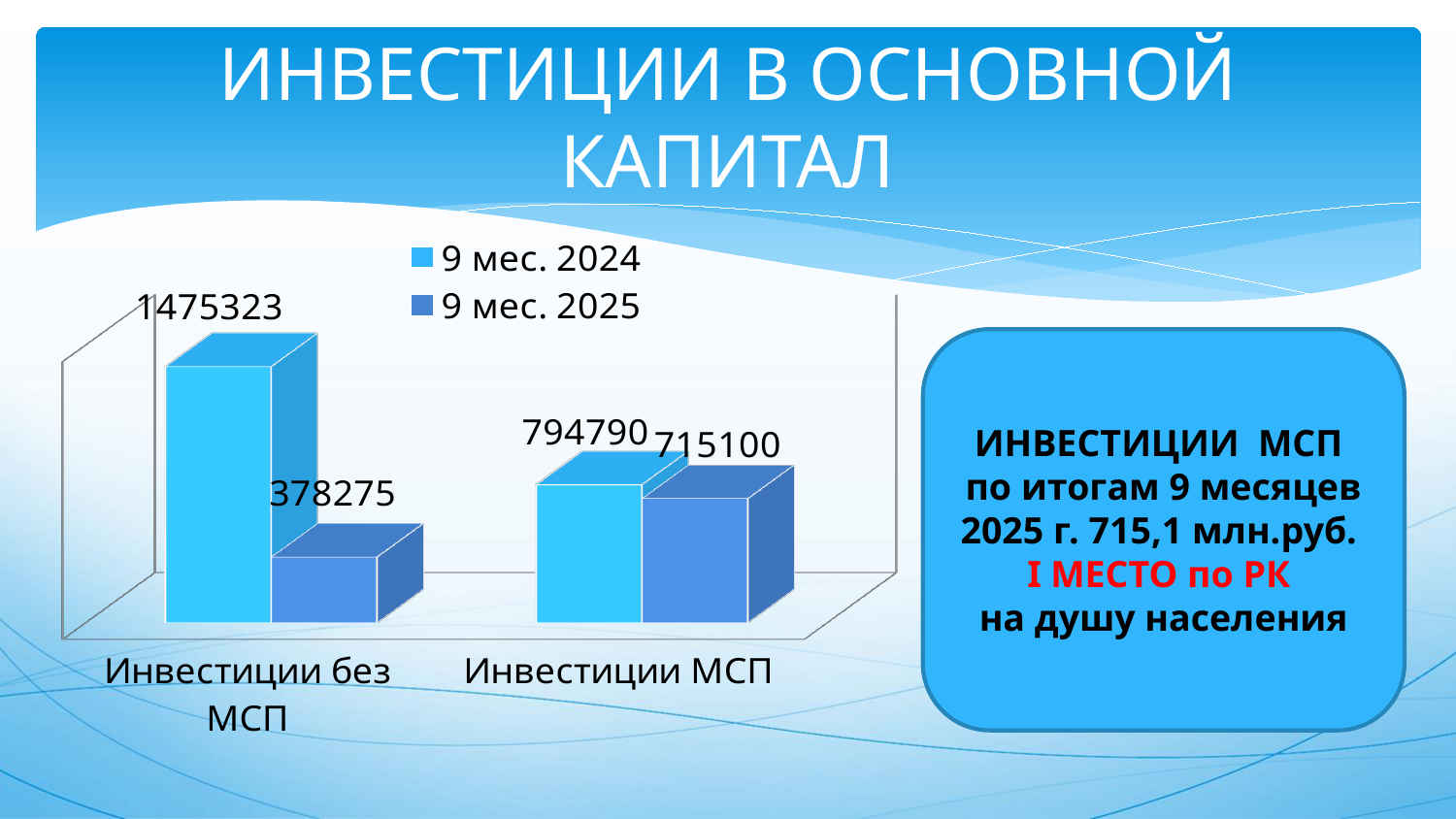
What is the difference between the '9 мес. 2024' and '9 мес. 2025' values for 'Инвестиции МСП'? 79690 What is the difference between the '9 мес. 2024' and '9 мес. 2025' values for 'Инвестиции без МСП'? 1097048 For 'Инвестиции МСП', which series has the larger value: '9 мес. 2024' or '9 мес. 2025'? 9 мес. 2024 What is the value for 'Инвестиции без МСП' in the '9 мес. 2025' series? 378275 Which bar has the highest value on the chart? Инвестиции без МСП, 9 мес. 2024 What is the value for 'Инвестиции без МСП' in the '9 мес. 2024' series? 1475323 What is the value for 'Инвестиции МСП' in the '9 мес. 2025' series? 715100 How many series does the chart legend list? 2 What is the value for 'Инвестиции МСП' in the '9 мес. 2024' series? 794790 Which bar has the lowest value on the chart? Инвестиции без МСП, 9 мес. 2025 What kind of chart is shown on the slide? Bar chart How many categories are shown on the x axis of the chart? 2